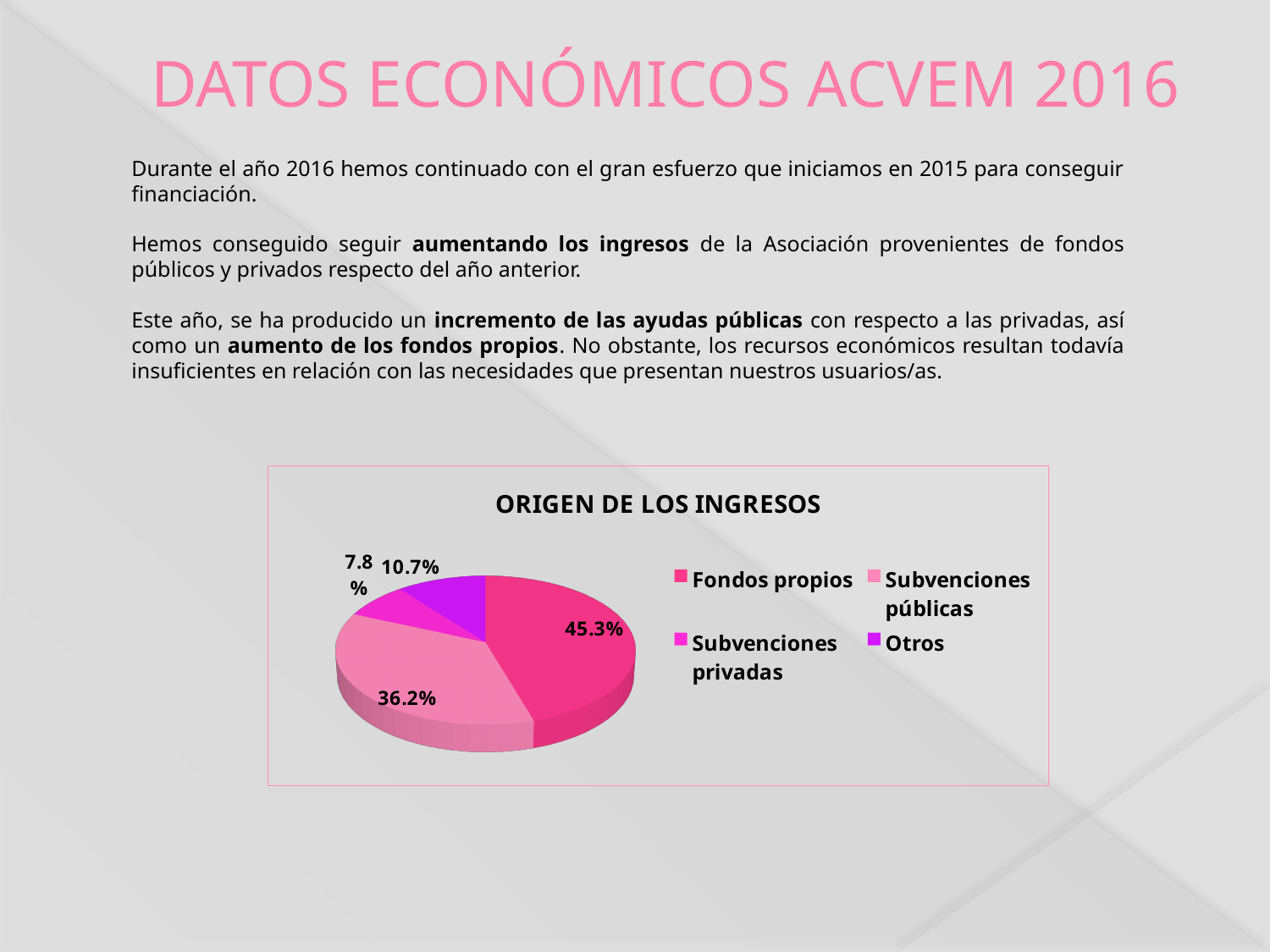
Which category has the smallest share of the pie? Subvenciones privadas Which is larger, the share for Otros or the share for Subvenciones privadas? Otros What share of the pie is Otros? 10.7% How many entries does the legend list? 4 What share of the pie is Fondos propios? 45.3% What is the difference between the shares of Fondos propios and Subvenciones públicas? 9.1% How many slices does the pie chart have? 4 What share of the pie is Subvenciones privadas? 7.8% Which category has the largest share of the pie? Fondos propios What is the title of the chart? ORIGEN DE LOS INGRESOS What type of chart is shown on the slide? pie chart